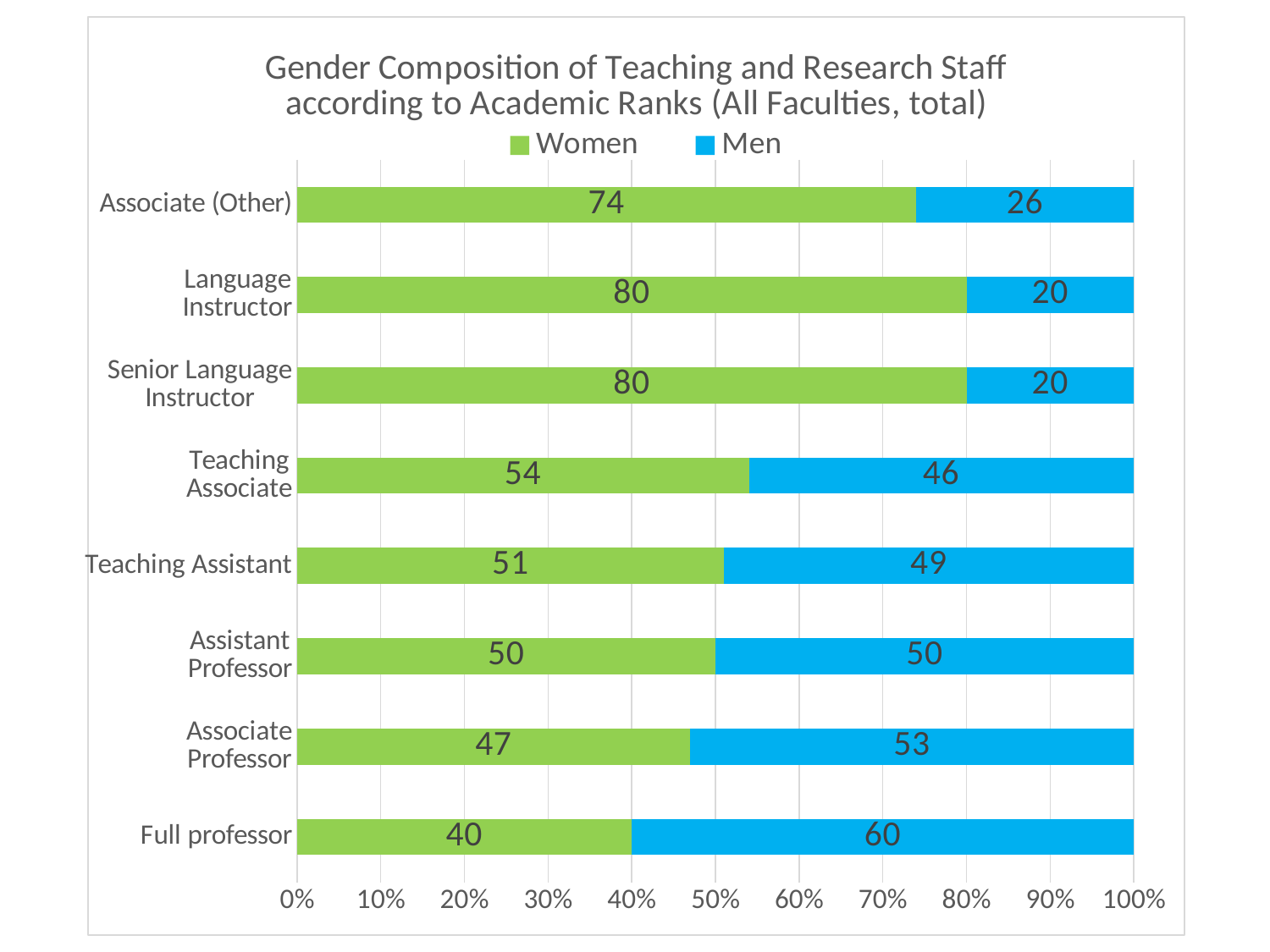
What is the total of the stacked bar for Teaching Assistant? 100 What kind of chart is shown on the slide? Stacked bar chart Which colour represents Women in the chart? Green Which is larger for Associate Professor, the Women value or the Men value? Men What is the difference between the Men and Women values for Full professor? 20 What is the Women value for Associate (Other)? 74 How many series does the legend list? 2 What is the Men value for Teaching Associate? 46 Which category has the lowest Women value? Full professor Which category has the highest Men value? Full professor What is the Women value for Full professor? 40 How many categories are shown on the chart? 8